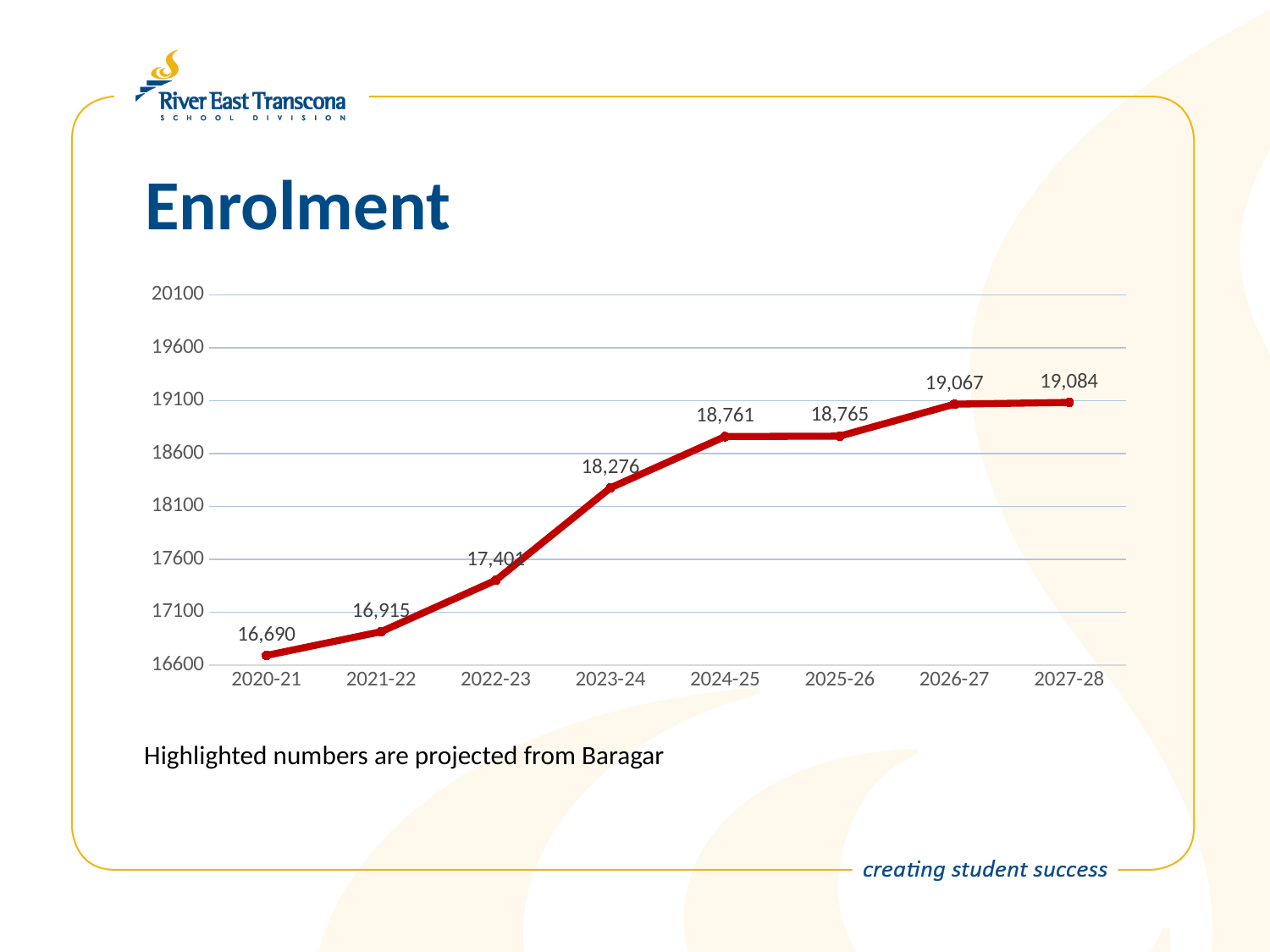
Which year has the highest enrolment? 2027-28 How many school years are plotted on the chart? 8 What kind of chart is shown on the slide? line chart Is the enrolment value for 2024-25 greater or less than 18600? greater What is the enrolment value for 2026-27? 19,067 What is the enrolment value for 2020-21? 16,690 What is the enrolment value for 2023-24? 18,276 What is the difference in enrolment between 2023-24 and 2022-23? 875 Do the enrolment values rise or fall from 2020-21 to 2027-28? rise Which is larger, the enrolment for 2021-22 or for 2022-23? 2022-23 What is the difference in enrolment between 2027-28 and 2020-21? 2,394 Which year has the lowest enrolment? 2020-21